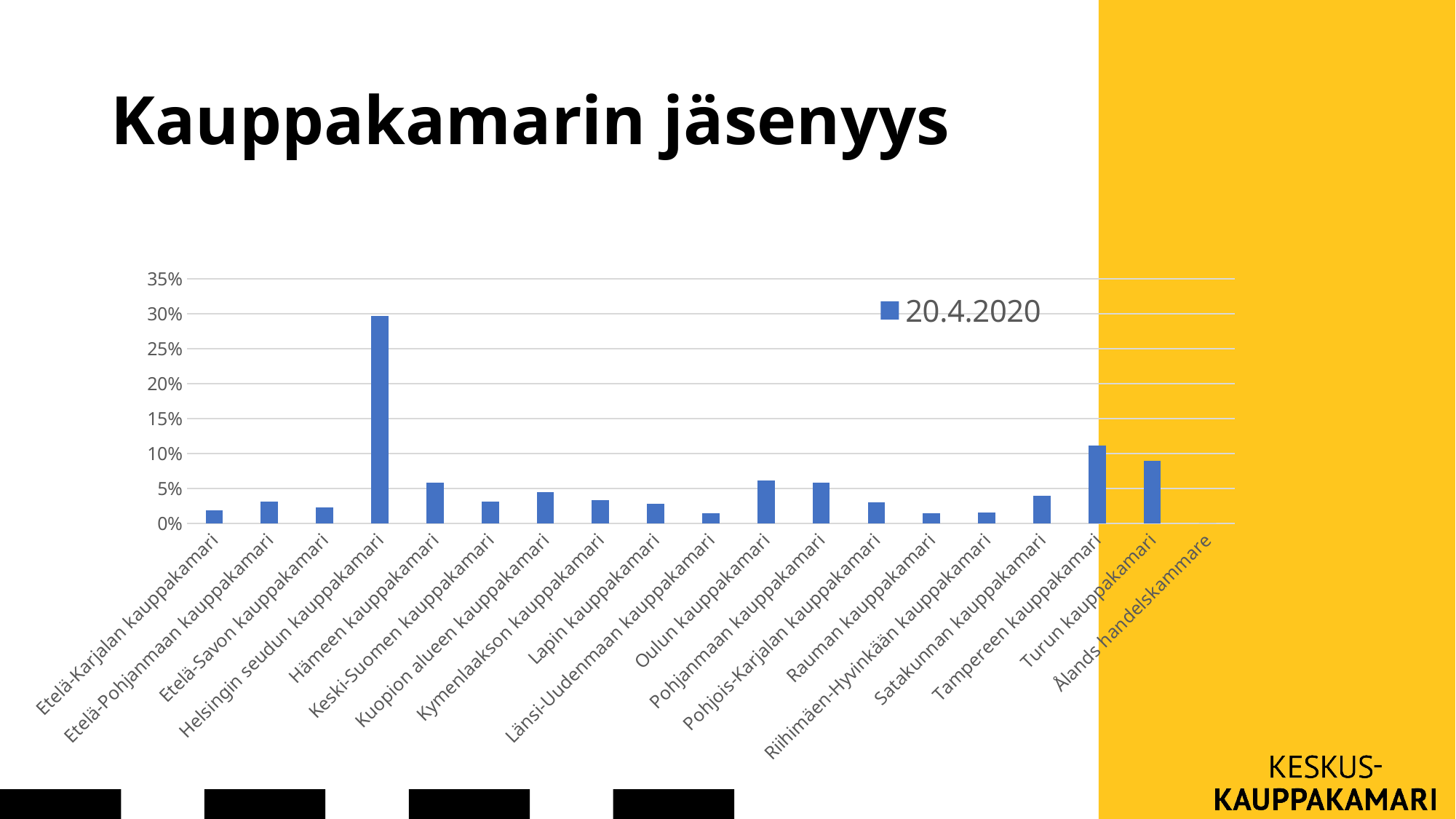
Which category has the highest value in the chart? Helsingin seudun kauppakamari What is the title of the chart on the slide? Kauppakamarin jäsenyys What kind of chart is shown on the slide? bar chart How many categories are shown on the x axis of the chart? 19 How many series does the legend list? 1 Which is larger, the value for Tampereen kauppakamari or the value for Turun kauppakamari? Tampereen kauppakamari Is the value for Helsingin seudun kauppakamari greater or less than 25%? greater Is the value for Etelä-Karjalan kauppakamari greater or less than 5%? less What is the legend entry for the series shown in the chart? 20.4.2020 Is the value for Turun kauppakamari greater or less than 10%? less Which is larger, the value for Oulun kauppakamari or the value for Lapin kauppakamari? Oulun kauppakamari